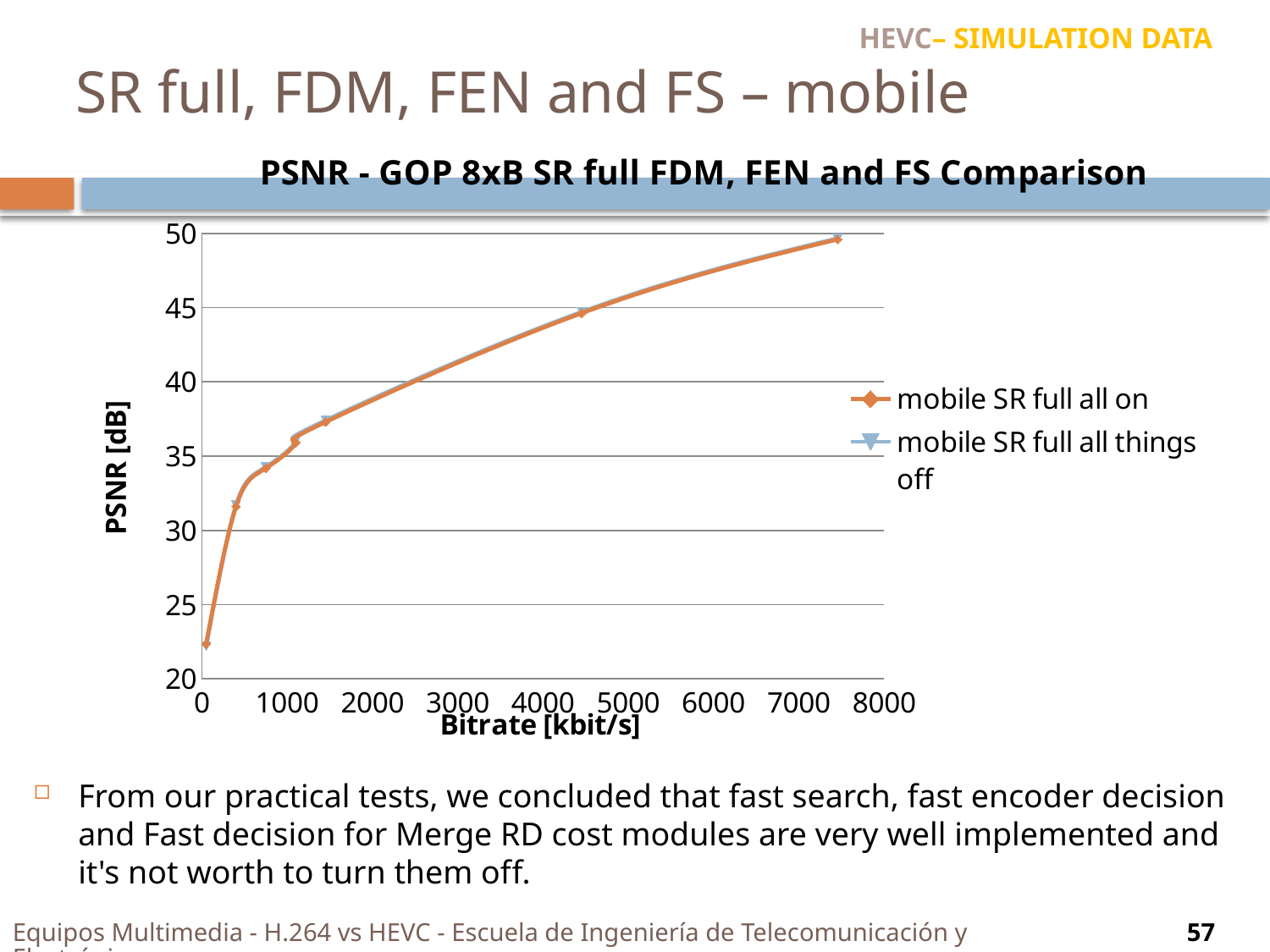
Does PSNR rise or fall as bitrate increases along the x axis? rise Is the PSNR value for 'mobile SR full all on' at its lowest bitrate point greater or less than 25? less Which series is drawn in orange? mobile SR full all on What is the title of the chart? PSNR - GOP 8xB SR full FDM, FEN and FS Comparison What is the label of the y axis? PSNR [dB] Is the PSNR value for 'mobile SR full all on' at around 4500 kbit/s greater or less than 40? greater Is the PSNR value for 'mobile SR full all on' at its highest bitrate point greater or less than 45? greater How many series does the legend list? 2 What kind of chart is shown on the slide? line chart